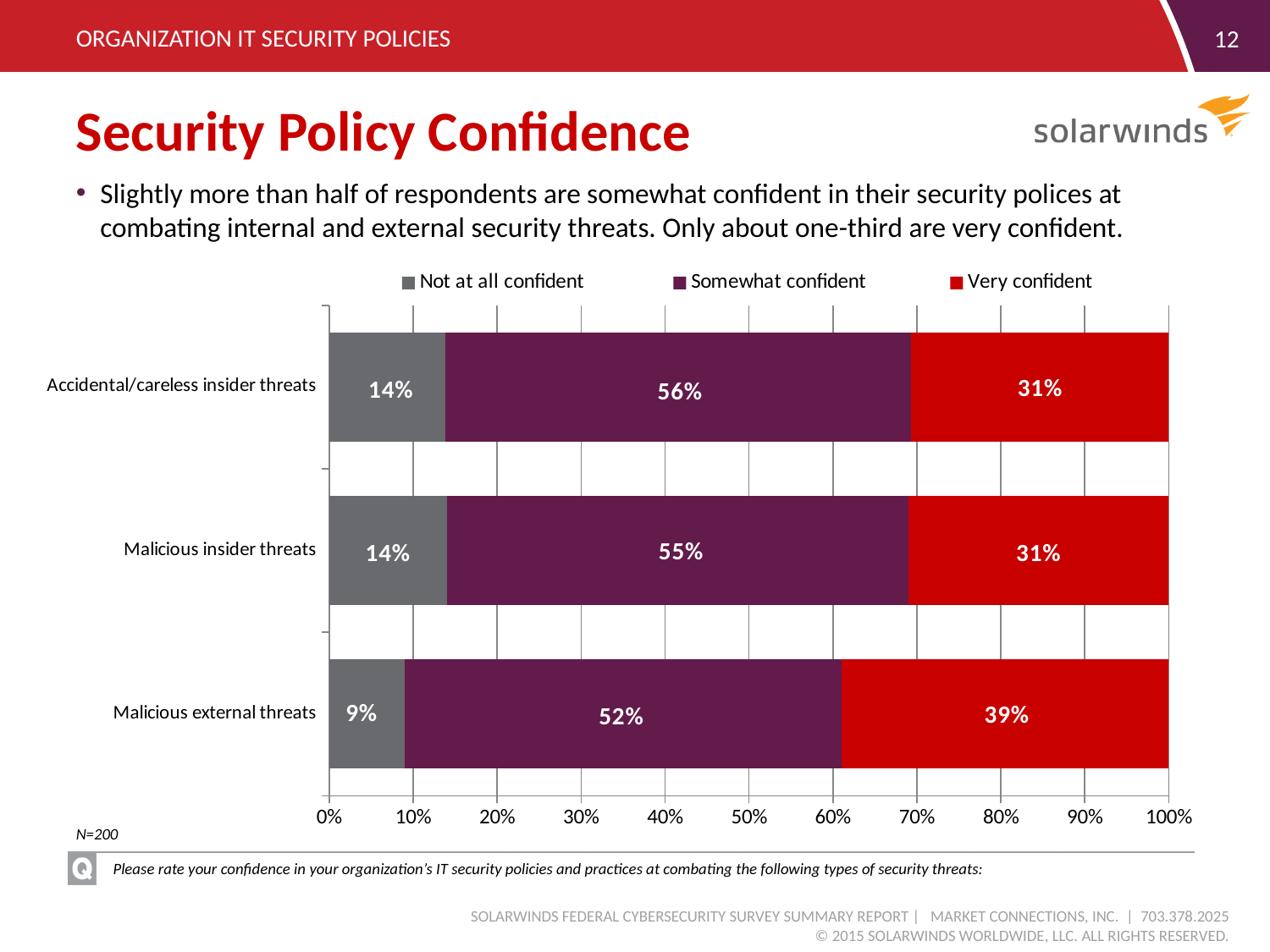
What is the difference between the 'Very confident' percentages for Malicious external threats and Malicious insider threats? 8% What is the total of the stacked bar for Malicious external threats? 100% What percentage of respondents are 'Not at all confident' for Malicious insider threats? 14% How many threat categories are shown in the chart? 3 What kind of chart is shown on the slide? Stacked bar chart Which category has the lowest 'Not at all confident' percentage? Malicious external threats What percentage of respondents are 'Somewhat confident' for Accidental/careless insider threats? 56% Which colour represents 'Very confident' in the chart? Red Which category has the highest 'Very confident' percentage? Malicious external threats How many series does the legend list? 3 Is the 'Somewhat confident' percentage larger for Accidental/careless insider threats or for Malicious external threats? Accidental/careless insider threats What percentage of respondents are 'Very confident' for Malicious external threats? 39%